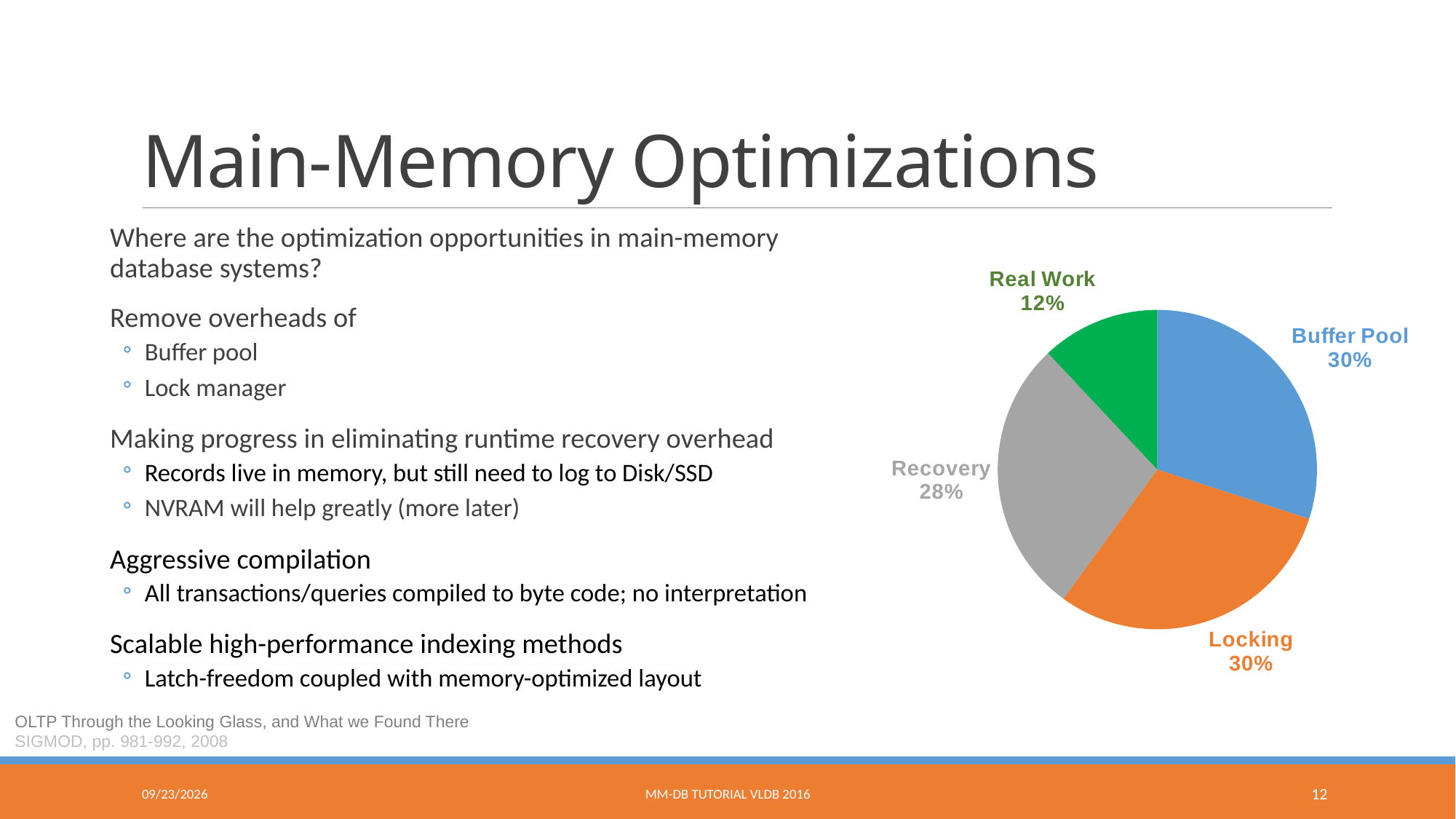
Which slice of the pie is the smallest? Real Work What is the difference in percentage points between Recovery and Real Work? 16 What share of the pie does Recovery account for? 28% What kind of chart is shown on the slide? pie chart What share of the pie does Real Work account for? 12% What is the difference in percentage points between Buffer Pool and Recovery? 2 Which is larger, the Recovery slice or the Real Work slice? Recovery What colour is the Locking slice of the pie? orange How many slices does the pie chart have? 4 What share of the pie does Buffer Pool account for? 30% What colour is the Real Work slice of the pie? green What share of the pie does Locking account for? 30%